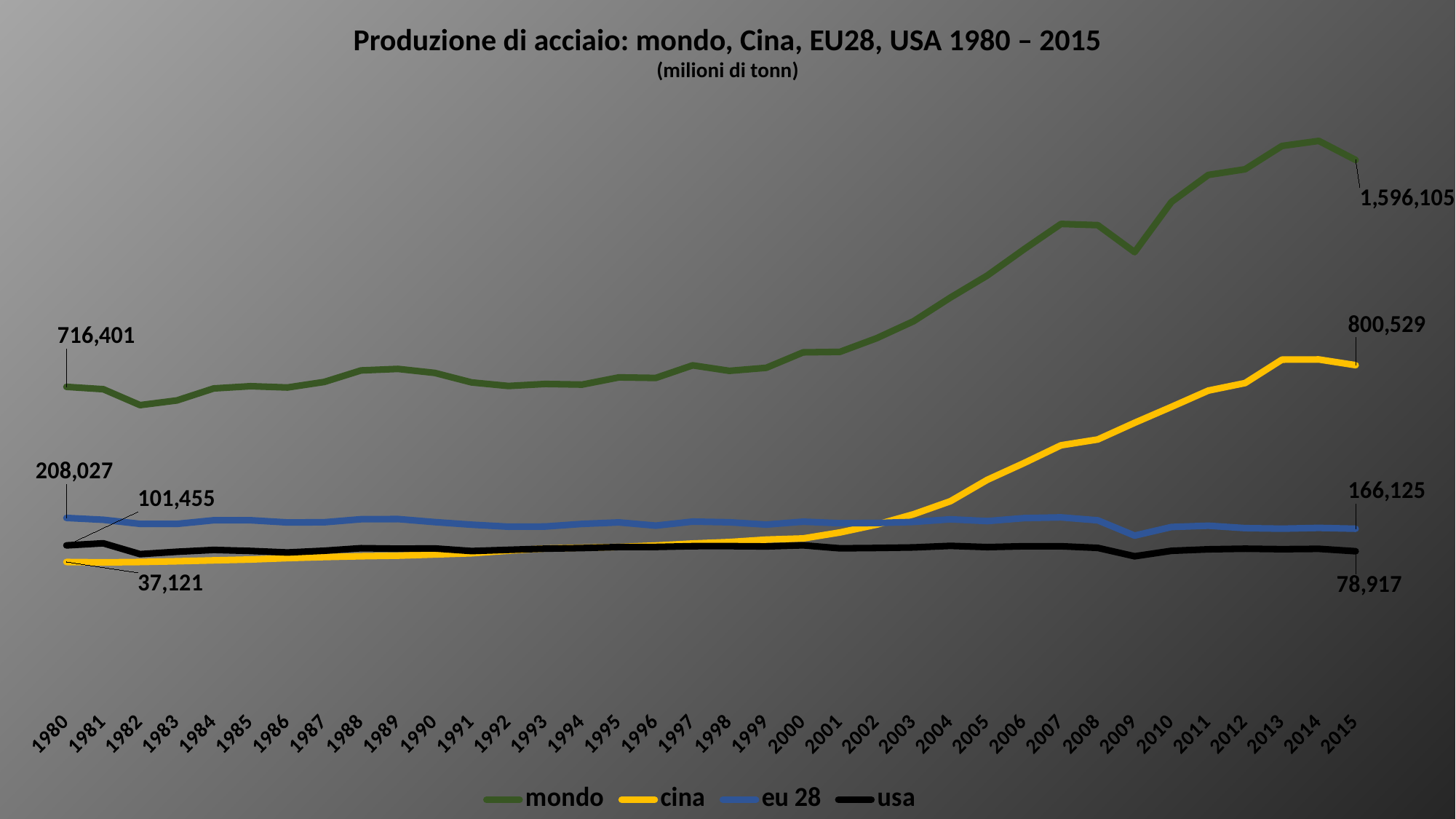
What is the value for mondo in 2015? 1,596,105 How many series does the legend list? 4 Which series has the highest value in 2015? mondo What is the value for usa in 2015? 78,917 In 2015, which is larger: the value for eu 28 or the value for usa? eu 28 What is the value for cina in 2015? 800,529 What is the value for eu 28 in 1980? 208,027 What is the difference between the eu 28 value in 1980 and in 2015? 41,902 What is the value for mondo in 1980? 716,401 By how much did the value for cina increase from 1980 to 2015? 763,408 Does the value for cina rise or fall from 1980 to 2015? rise Which series has the lowest value in 1980? cina